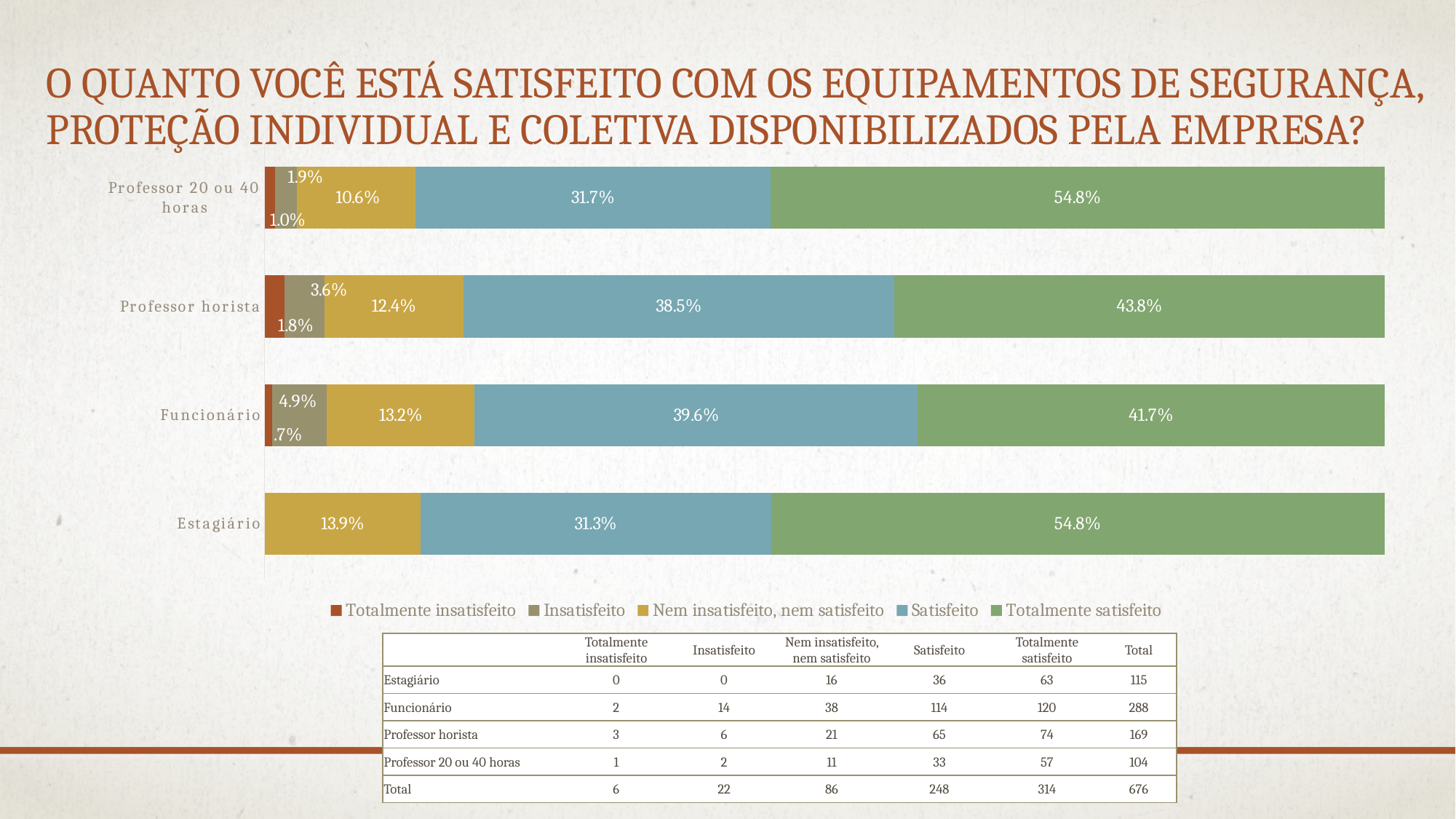
What is the value for Insatisfeito for Professor horista? 3.6% How many categories are shown on the chart? 4 Which category has the highest value for Satisfeito? Funcionário Which category has the lowest value for Totalmente satisfeito? Funcionário What is the value for Satisfeito for Funcionário? 39.6% What is the value for Totalmente satisfeito for Professor horista? 43.8% What colour represents Totalmente satisfeito in the legend? Green What is the difference between the Totalmente satisfeito values for Professor 20 ou 40 horas and Professor horista? 11.0 percentage points What kind of chart is shown on the slide? Stacked bar chart Which is larger, the Satisfeito value for Professor horista or for Estagiário? Professor horista What is the value for Nem insatisfeito, nem satisfeito for Estagiário? 13.9% How many series does the legend list? 5